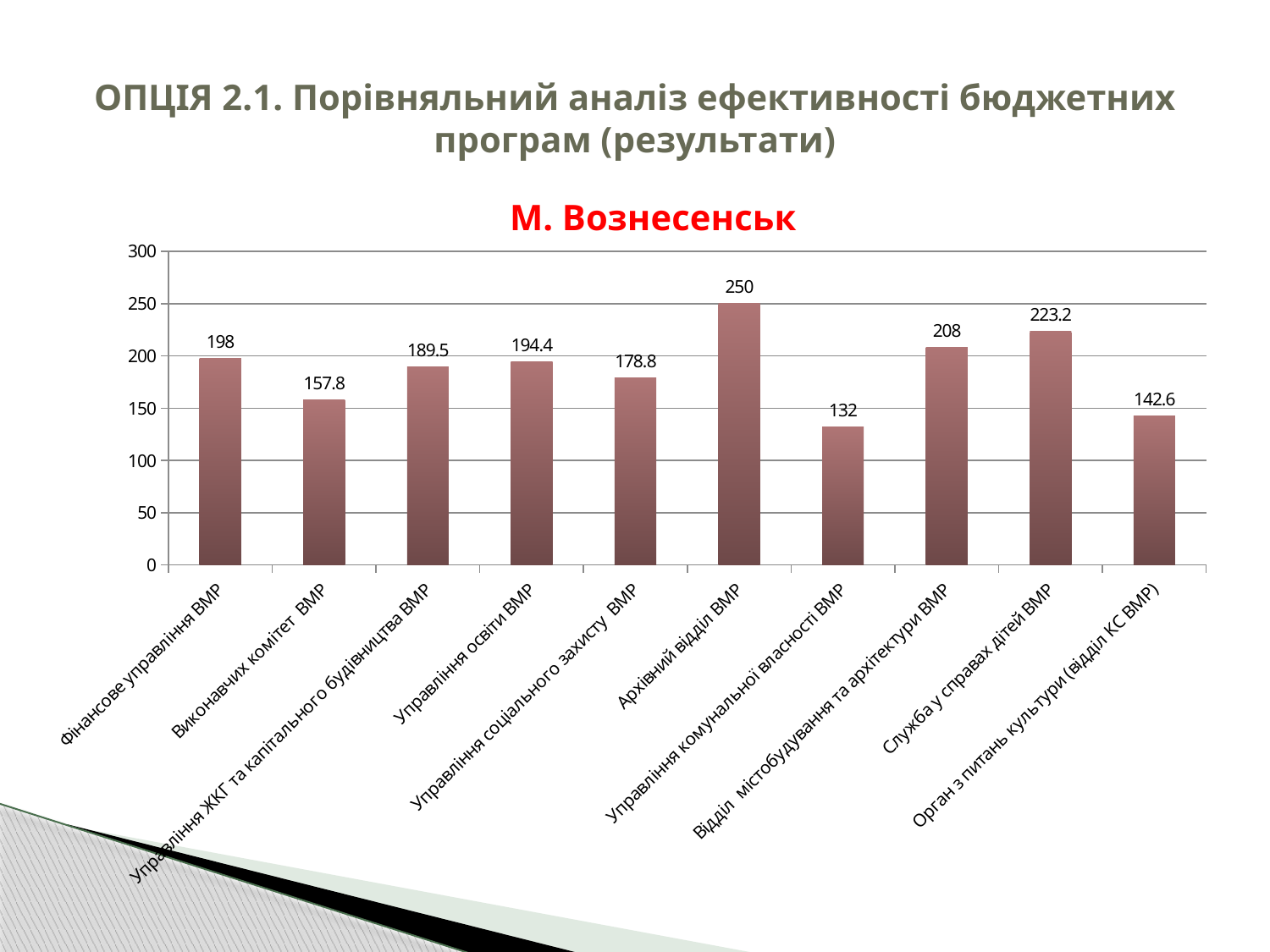
Which category has the lowest value? Управління комунальної власності ВМР What type of chart is shown on the slide? bar chart What is the value for Управління освіти ВМР? 194.4 Is the value for Управління соціального захисту ВМР greater or less than 200? less Which is larger, the value for Відділ містобудування та архітектури ВМР or the value for Служба у справах дітей ВМР? Служба у справах дітей ВМР What is the value for Орган з питань культури (відділ КС ВМР)? 142.6 What is the difference between the values for Архівний відділ ВМР and Управління комунальної власності ВМР? 118 How many categories are shown on the chart? 10 What is the value for Архівний відділ ВМР? 250 What is the value for Служба у справах дітей ВМР? 223.2 What is the difference between the values for Фінансове управління ВМР and Виконавчих комітет ВМР? 40.2 Which category has the highest value? Архівний відділ ВМР